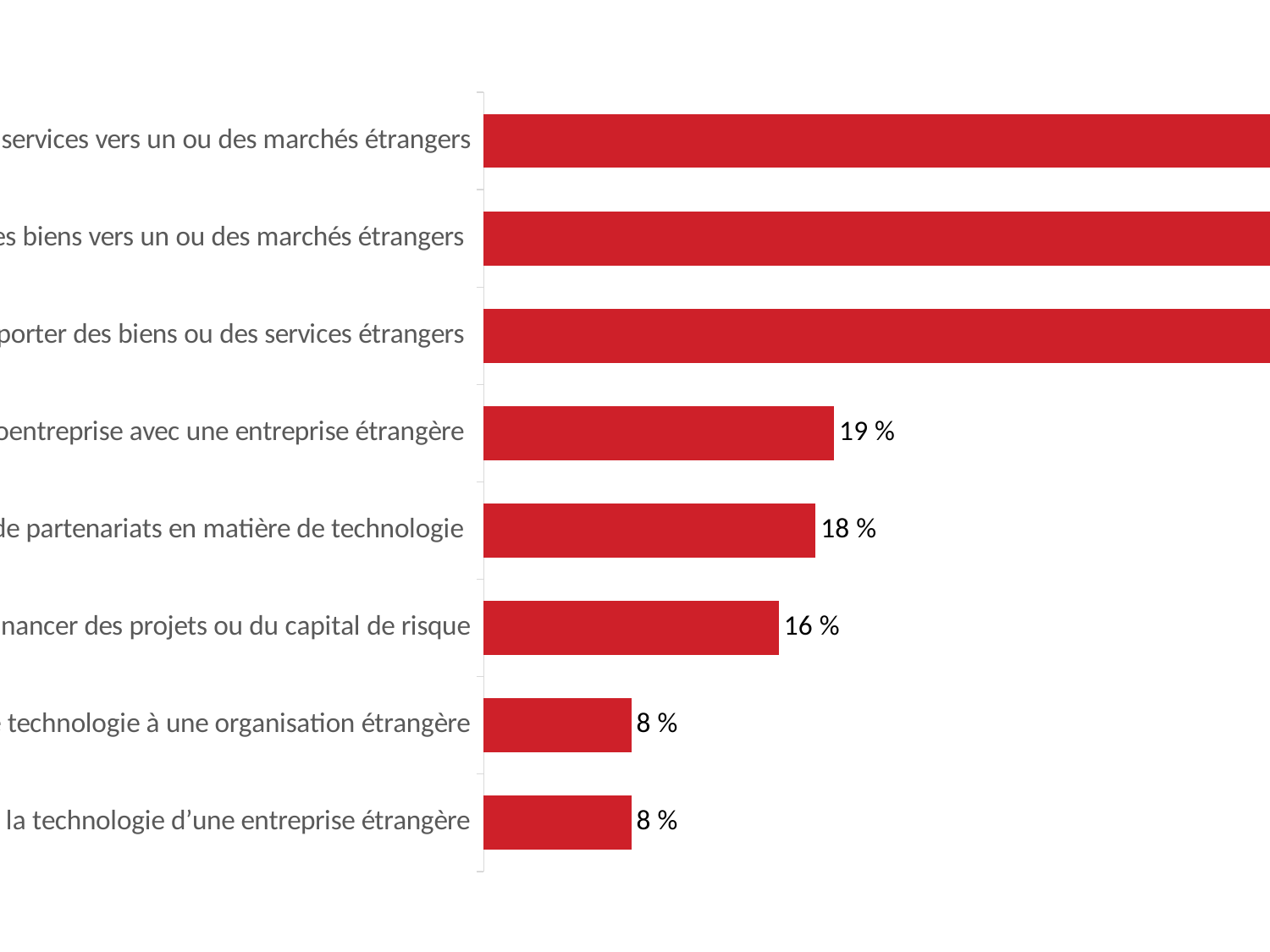
What is the value for the category ending in "entreprise avec une entreprise étrangère"? 19 % What is the value for the category ending in "des projets ou du capital de risque"? 16 % What is the lowest value labelled on the chart? 8 % What kind of chart is shown on the slide? bar chart What colour are the bars in the chart? red What is the value for the category ending in "technologie à une organisation étrangère"? 8 % Which has the larger value: the category ending in "entreprise avec une entreprise étrangère" or the category ending in "partenariats en matière de technologie"? entreprise avec une entreprise étrangère What is the value for the category ending in "la technologie d'une entreprise étrangère"? 8 % What is the value for the category ending in "partenariats en matière de technologie"? 18 % What is the difference between the value for the category ending in "entreprise avec une entreprise étrangère" and the category ending in "des projets ou du capital de risque"? 3 % How many categories (bars) does the chart show? 8 What is the difference between the value for the category ending in "partenariats en matière de technologie" and the category ending in "technologie à une organisation étrangère"? 10 %